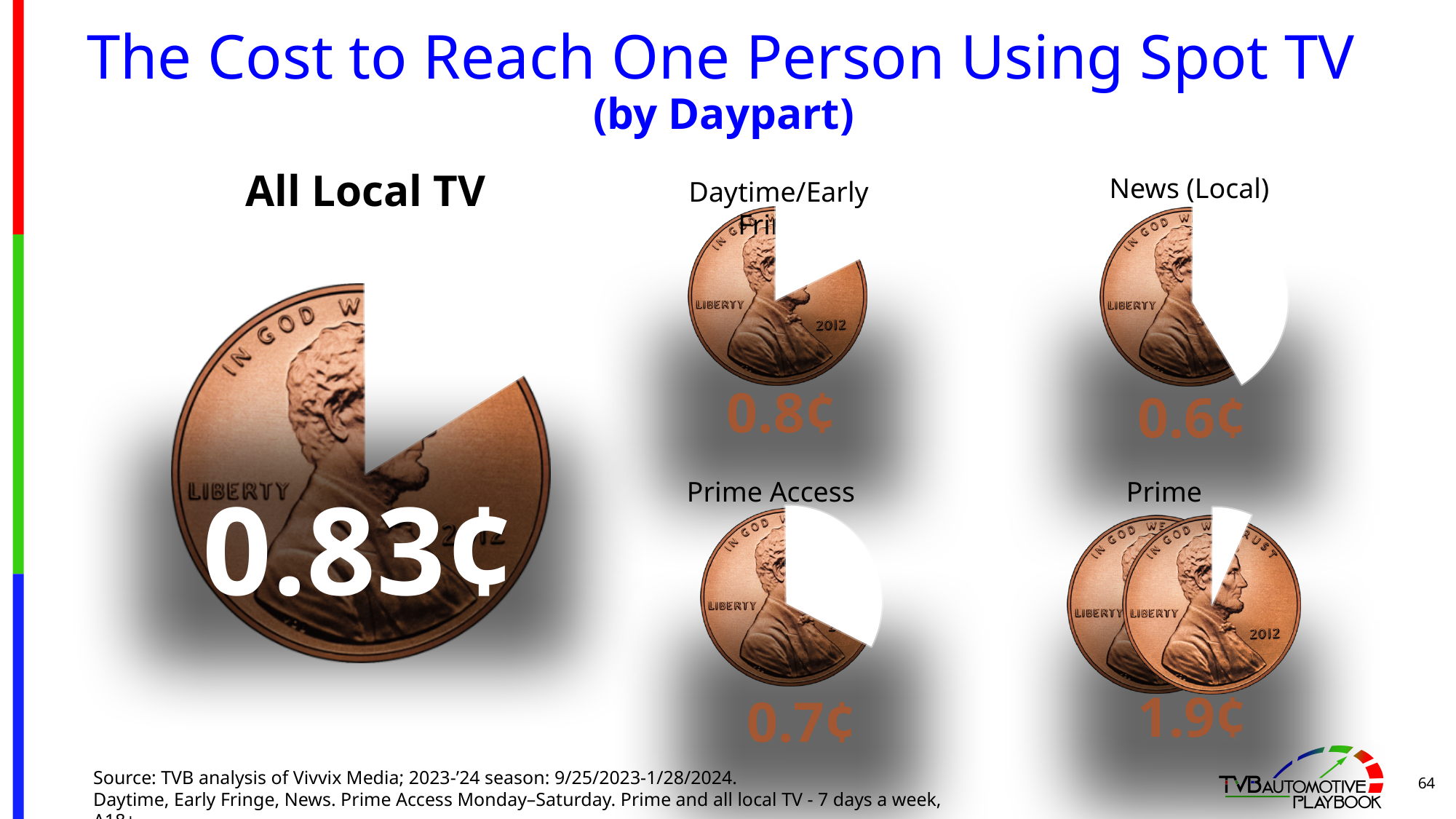
Which daypart has the lowest cost to reach one person? News (Local) What is the cost to reach one person in the Prime daypart? 1.9¢ What is the title of the slide? The Cost to Reach One Person Using Spot TV (by Daypart) Which has a higher cost to reach one person, Prime Access or Prime? Prime What is the cost to reach one person using All Local TV? 0.83¢ What is the cost to reach one person in the Daytime/Early Fringe daypart? 0.8¢ What is the cost to reach one person in the News (Local) daypart? 0.6¢ How many individual dayparts (excluding All Local TV) are shown on the slide? 4 Which daypart has the highest cost to reach one person? Prime What is the difference in cost per person between Prime and News (Local)? 1.3¢ What is the difference in cost per person between Daytime/Early Fringe and Prime Access? 0.1¢ What is the cost to reach one person in the Prime Access daypart? 0.7¢